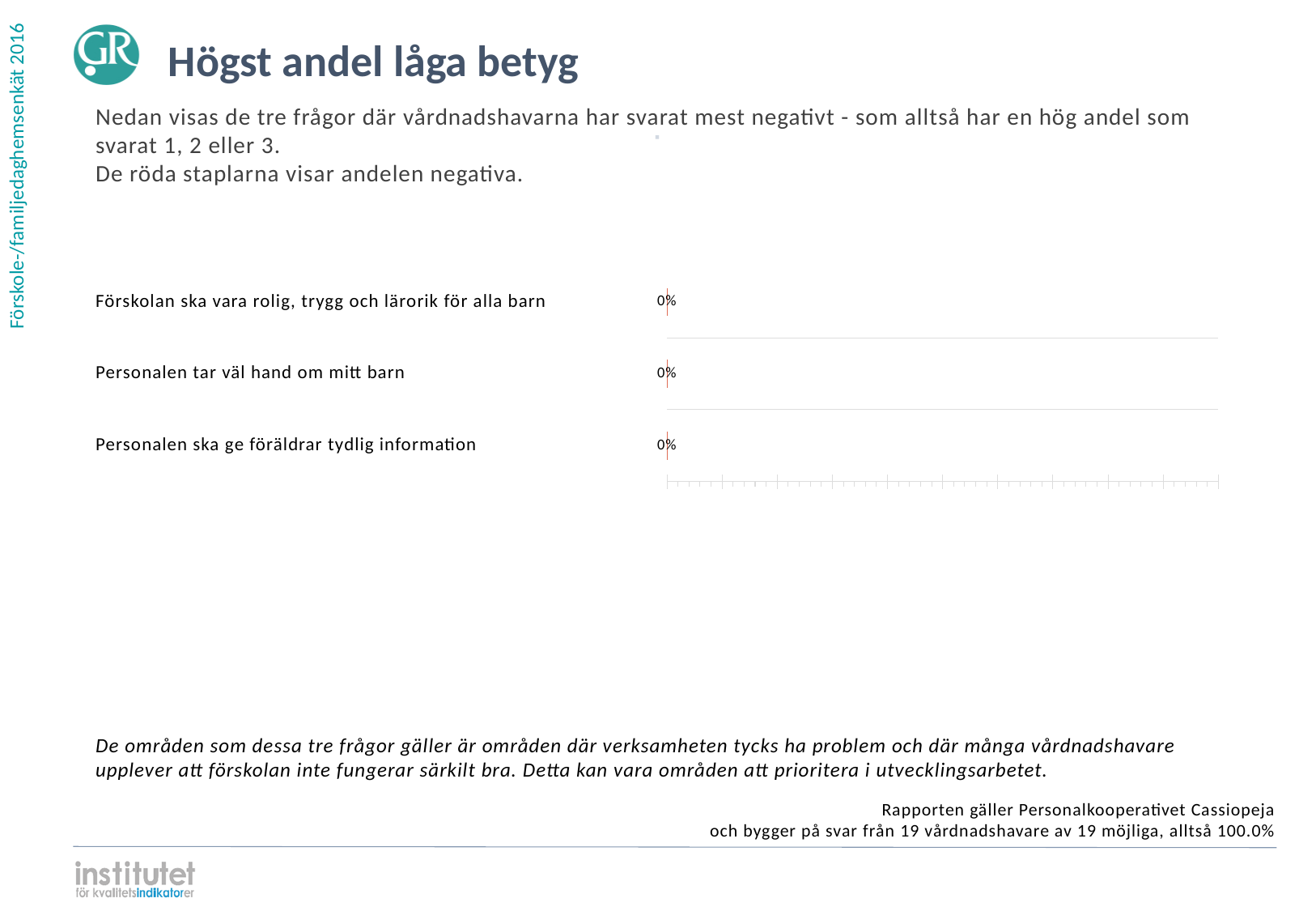
According to the slide text, what colour are the bars that show the share of negative answers? Red Do all three categories in the chart show the same value? Yes, 0% How many categories (questions) are plotted in the chart? 3 What value is shown for "Personalen tar väl hand om mitt barn"? 0% What value is shown for "Förskolan ska vara rolig, trygg och lärorik för alla barn"? 0% What is the title of the slide containing the chart? Högst andel låga betyg What is the difference between the values for "Personalen tar väl hand om mitt barn" and "Personalen ska ge föräldrar tydlig information"? 0% What kind of chart is shown on the slide? Bar chart What value is shown for "Personalen ska ge föräldrar tydlig information"? 0%